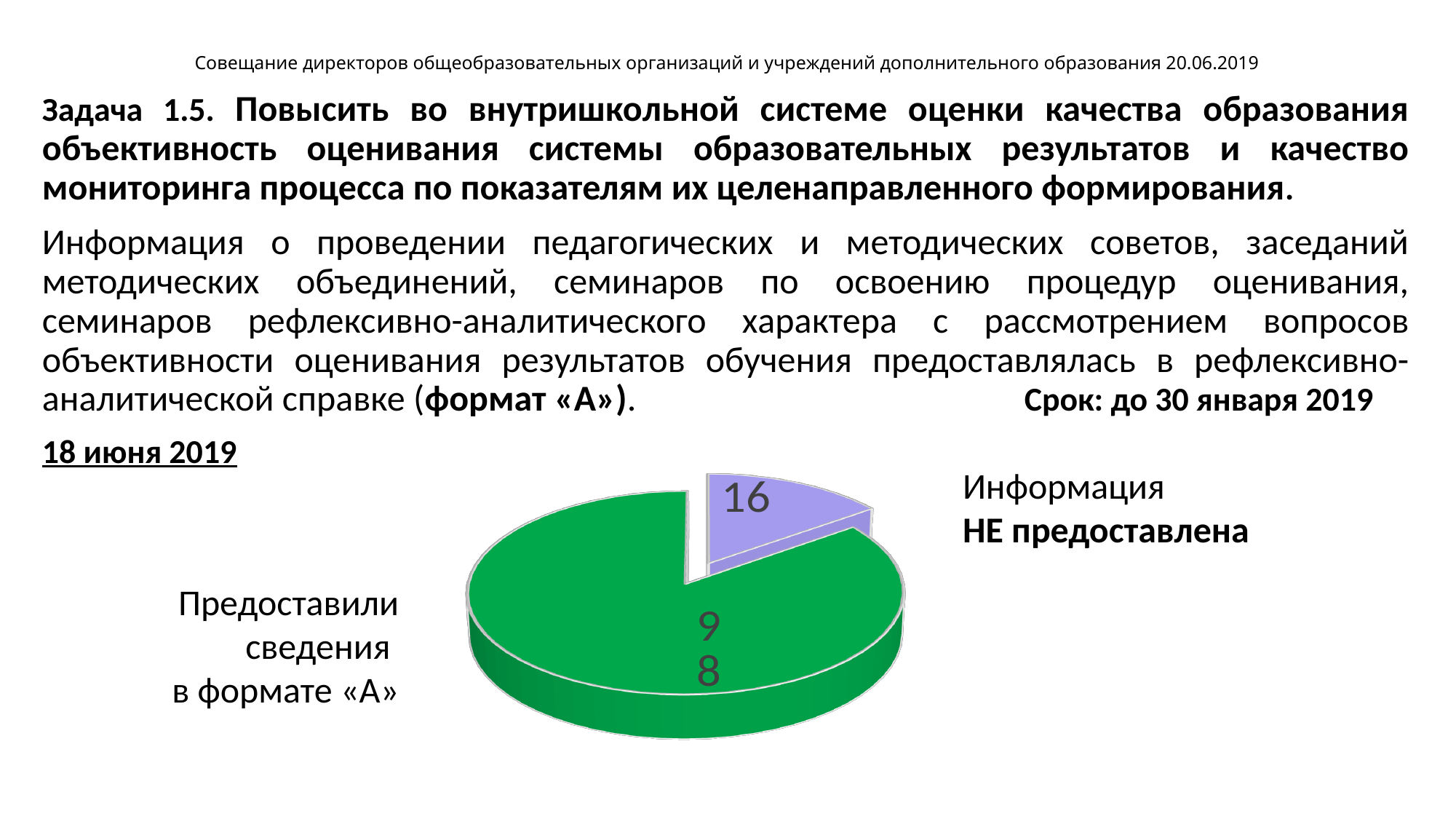
Which category has the larger slice in the pie chart? Предоставили сведения в формате «А» What is the difference between the number that provided information in format «А» and the number that did not? 82 What is the total of the two values shown in the pie chart? 114 Which category has the smaller slice in the pie chart? Информация НЕ предоставлена What kind of chart is shown on the slide? Pie chart How many organisations did NOT provide information according to the pie chart? 16 How many slices does the pie chart have? 2 What colour is the slice for organisations that did not provide information? Purple Which is larger: the number that provided information in format «А» or the number that did not provide information? Предоставили сведения в формате «А» What colour is the slice for organisations that provided information in format «А»? Green How many organisations provided information in format «А» according to the pie chart? 98